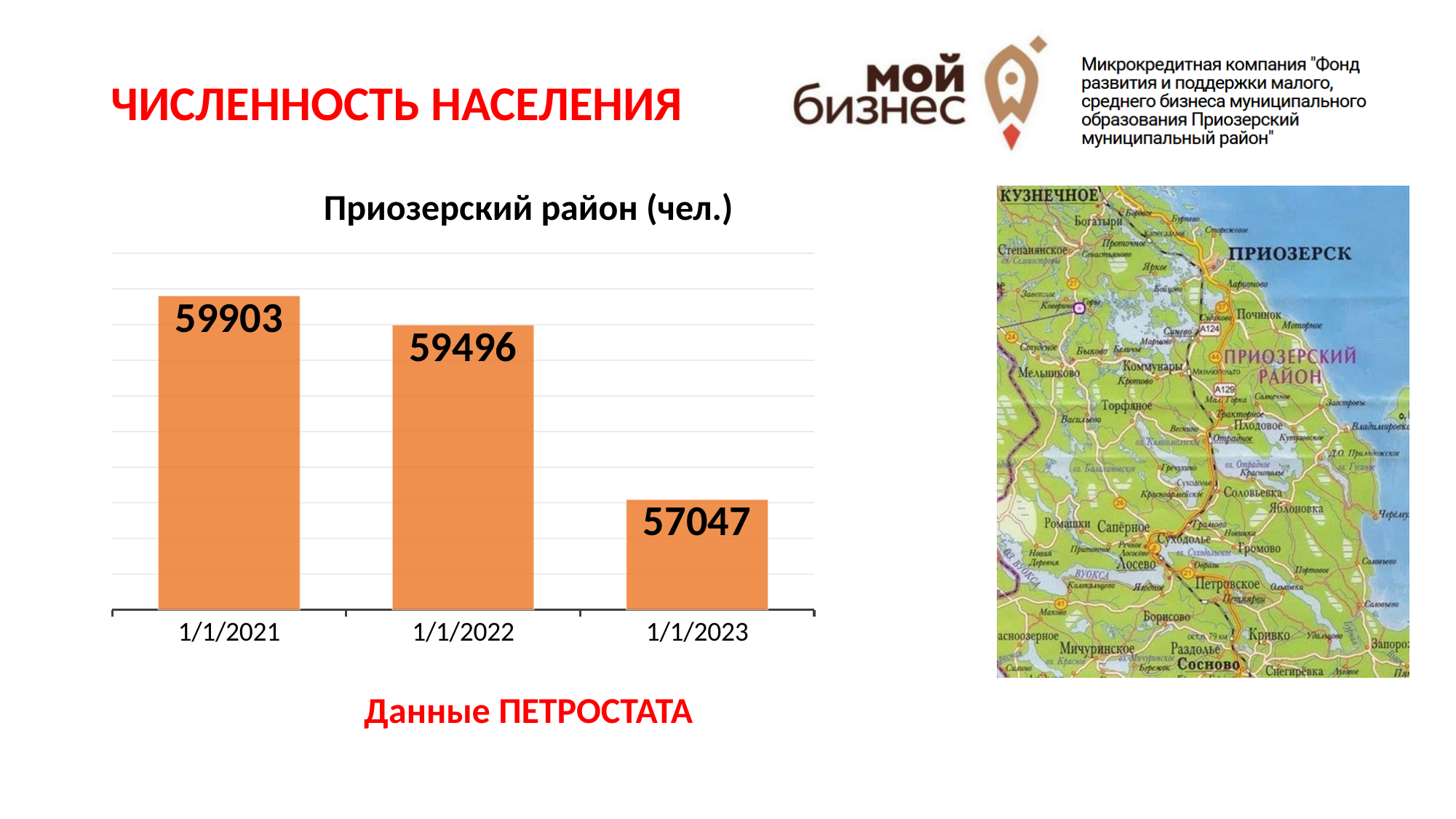
What is the population value shown for 1/1/2022? 59496 Which date has the lowest population value? 1/1/2023 What is the population value shown for 1/1/2021? 59903 What is the difference between the values for 1/1/2021 and 1/1/2023? 2856 Do the values rise or fall from 1/1/2021 to 1/1/2023? fall What is the difference between the values for 1/1/2022 and 1/1/2023? 2449 Which is larger, the value for 1/1/2021 or the value for 1/1/2022? 1/1/2021 Which date has the highest population value? 1/1/2021 What is the population value shown for 1/1/2023? 57047 What is the title of the chart? Приозерский район (чел.) What kind of chart is shown on the slide? bar chart How many bars are shown in the chart? 3